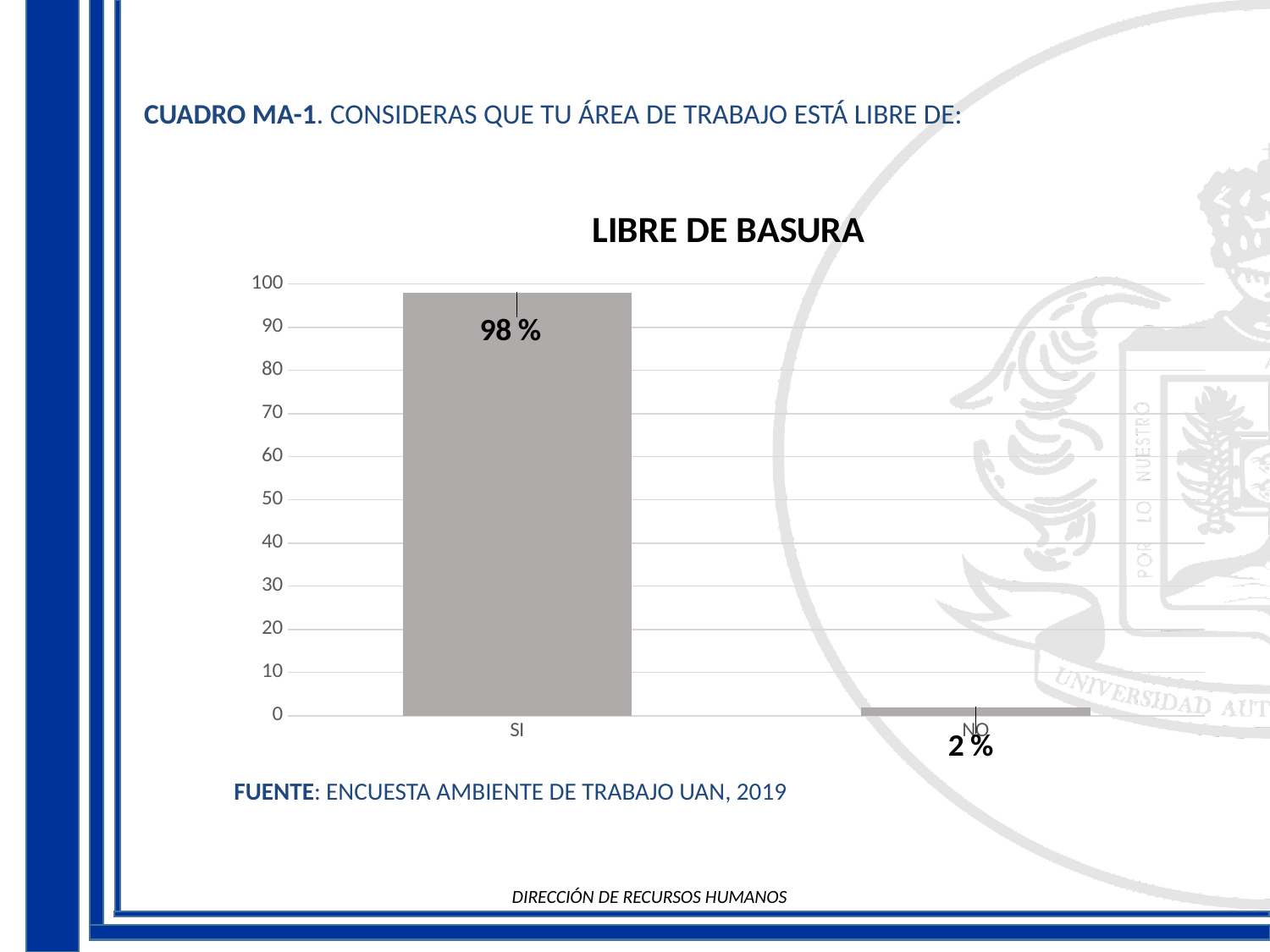
What kind of chart is the LIBRE DE BASURA chart? bar chart Which category has the lowest value in the LIBRE DE BASURA chart? NO Which is larger in the LIBRE DE BASURA chart, the value for SI or the value for NO? SI What is the value for SI in the LIBRE DE BASURA chart? 98 % How many categories are shown in the LIBRE DE BASURA chart? 2 What is the maximum value shown on the vertical axis of the LIBRE DE BASURA chart? 100 What is the difference between the values for SI and NO in the LIBRE DE BASURA chart? 96 % What is the value for NO in the LIBRE DE BASURA chart? 2 % What is the title of the chart on the slide? LIBRE DE BASURA Is the value for NO in the LIBRE DE BASURA chart greater or less than 10? less Which category has the highest value in the LIBRE DE BASURA chart? SI Is the value for SI in the LIBRE DE BASURA chart greater or less than 90? greater